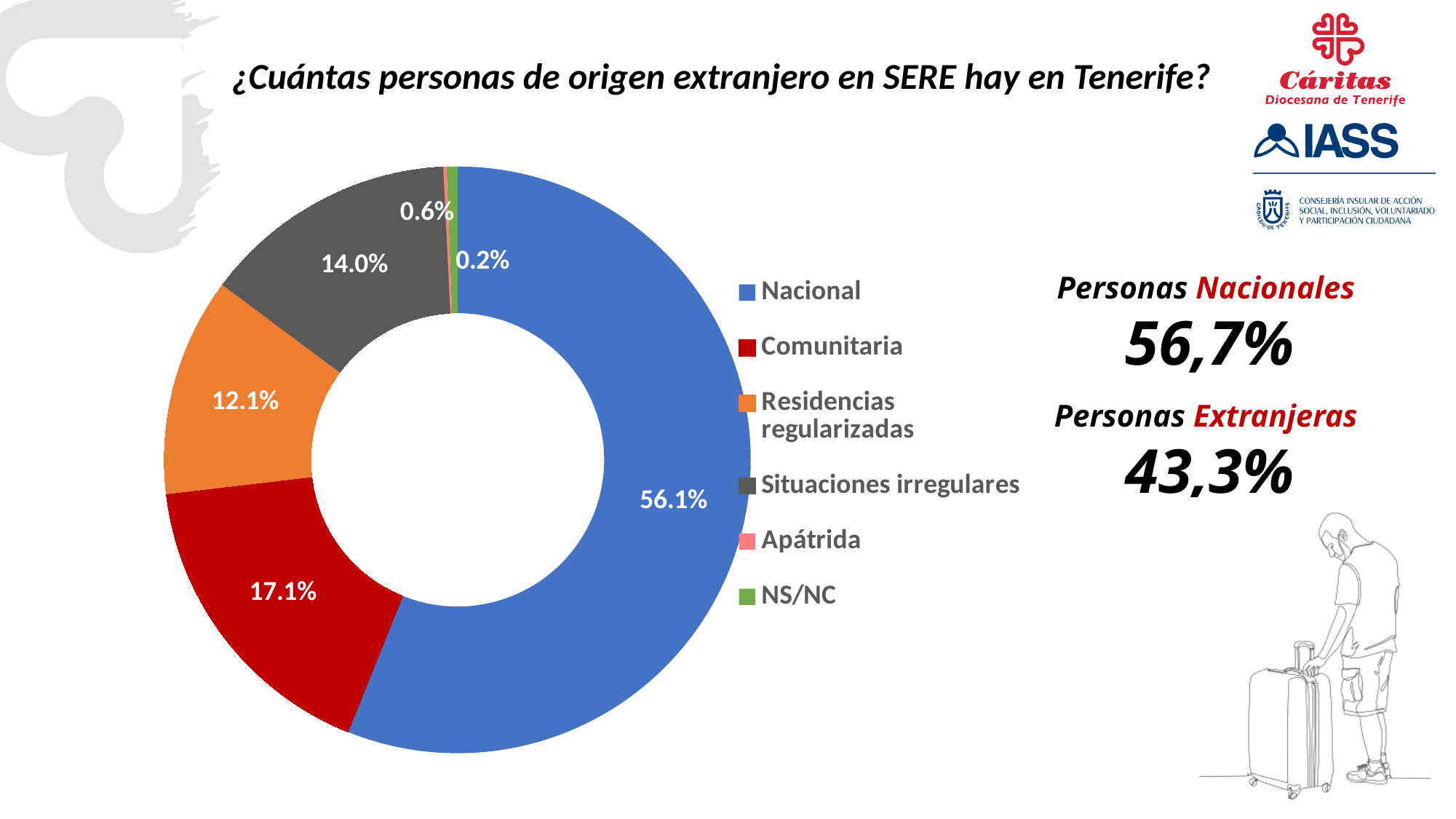
What percentage does the Nacional slice represent in the pie chart? 56.1% Which category has the largest slice in the pie chart? Nacional What kind of chart is shown on the slide? Pie chart (doughnut) What is the title question written above the chart? ¿Cuántas personas de origen extranjero en SERE hay en Tenerife? What is the difference in percentage points between the Nacional slice and the Comunitaria slice? 39.0 How many categories does the pie chart legend list? 6 What percentage is shown for Residencias regularizadas? 12.1% What percentage is shown for Situaciones irregulares? 14.0% What percentage is shown for the Comunitaria slice? 17.1% What is the difference in percentage points between Situaciones irregulares and Residencias regularizadas? 1.9 Which slice is larger, Comunitaria or Situaciones irregulares? Comunitaria Which colour represents the Residencias regularizadas category in the legend? Orange